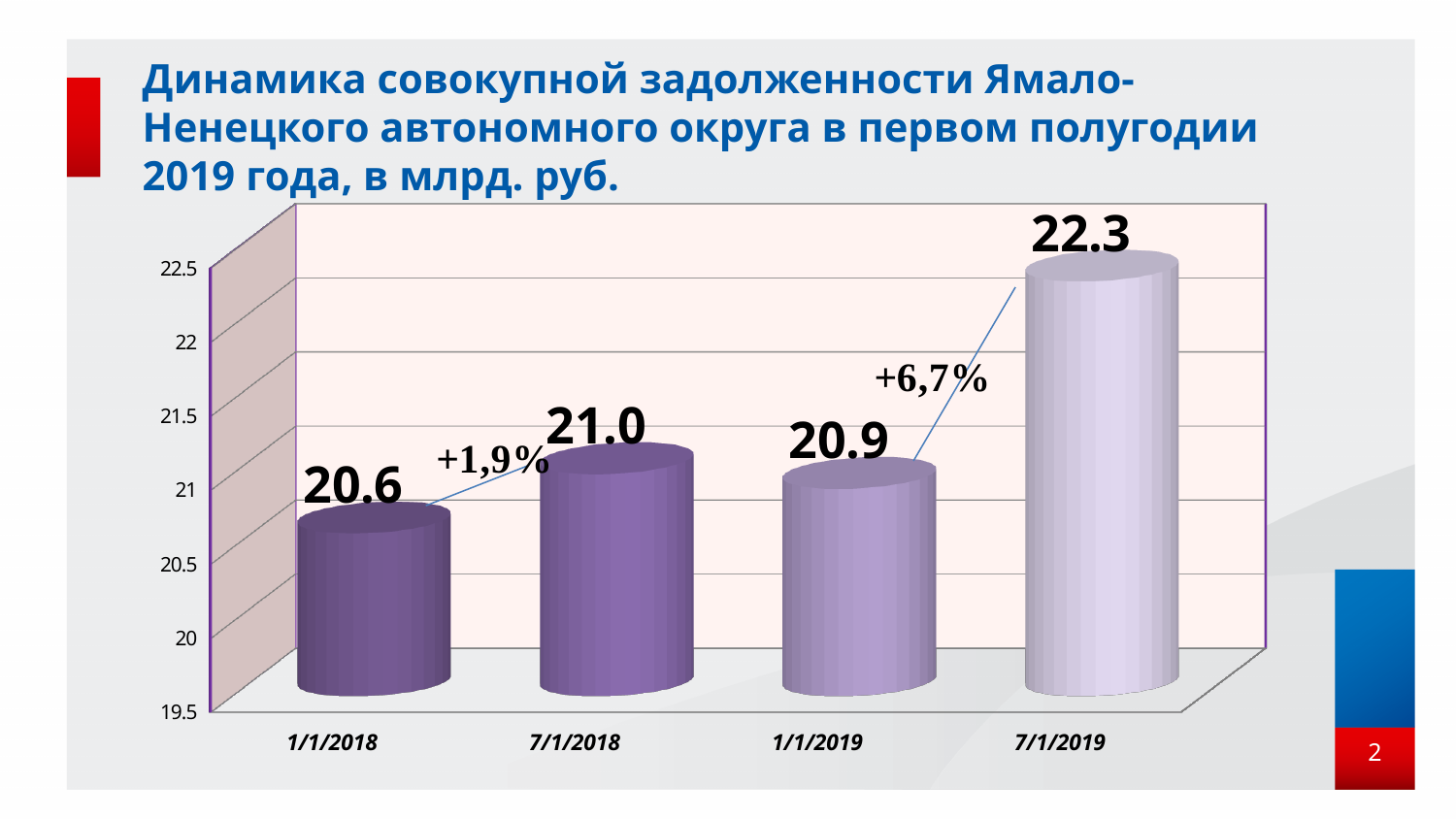
Which date has the highest value? 7/1/2019 What is the difference between the values for 7/1/2018 and 1/1/2018? 0.4 Which date has the lowest value? 1/1/2018 What is the difference between the values for 7/1/2019 and 1/1/2019? 1.4 Is the value for 7/1/2019 greater or less than 22? greater Which is larger, the value for 7/1/2018 or the value for 1/1/2019? 7/1/2018 How many dates are shown on the x axis? 4 What is the value for 1/1/2018? 20.6 What kind of chart is shown on the slide? bar chart What is the value for 1/1/2019? 20.9 What is the value for 7/1/2019? 22.3 What percentage change is labelled between 1/1/2019 and 7/1/2019? +6,7%